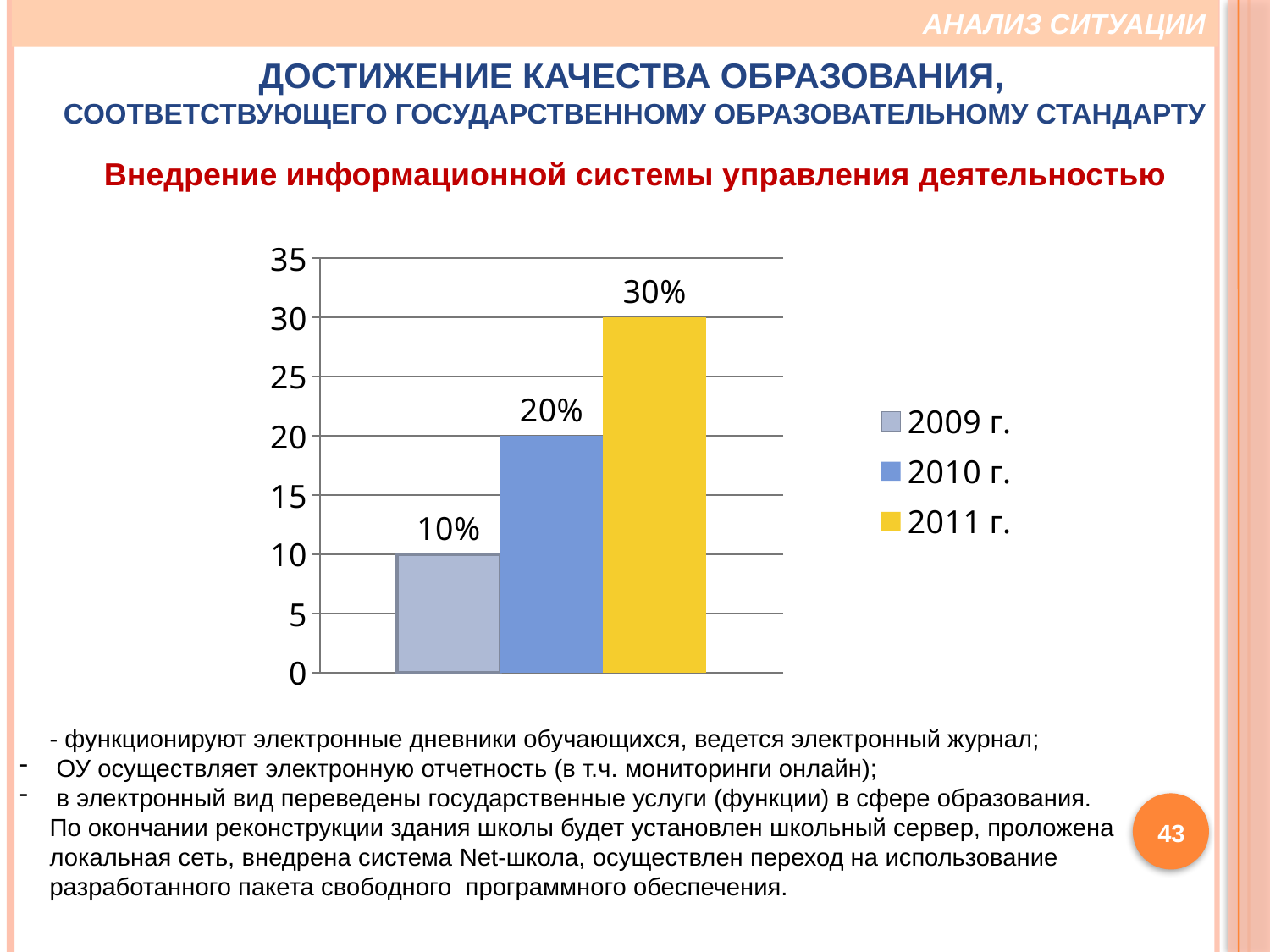
What is the difference between the values for 2010 г. and 2009 г.? 10% What is the value shown for 2010 г.? 20% Do the values rise or fall from 2009 г. to 2011 г.? Rise How many series does the legend list? 3 Which year has the lowest value? 2009 г. What is the difference between the values for 2011 г. and 2009 г.? 20% What is the value shown for 2009 г.? 10% What is the value shown for 2011 г.? 30% What kind of chart is shown on the slide? Bar chart Which is larger, the value for 2010 г. or the value for 2011 г.? 2011 г. Which year has the highest value? 2011 г. What colour is the bar for 2011 г.? Yellow